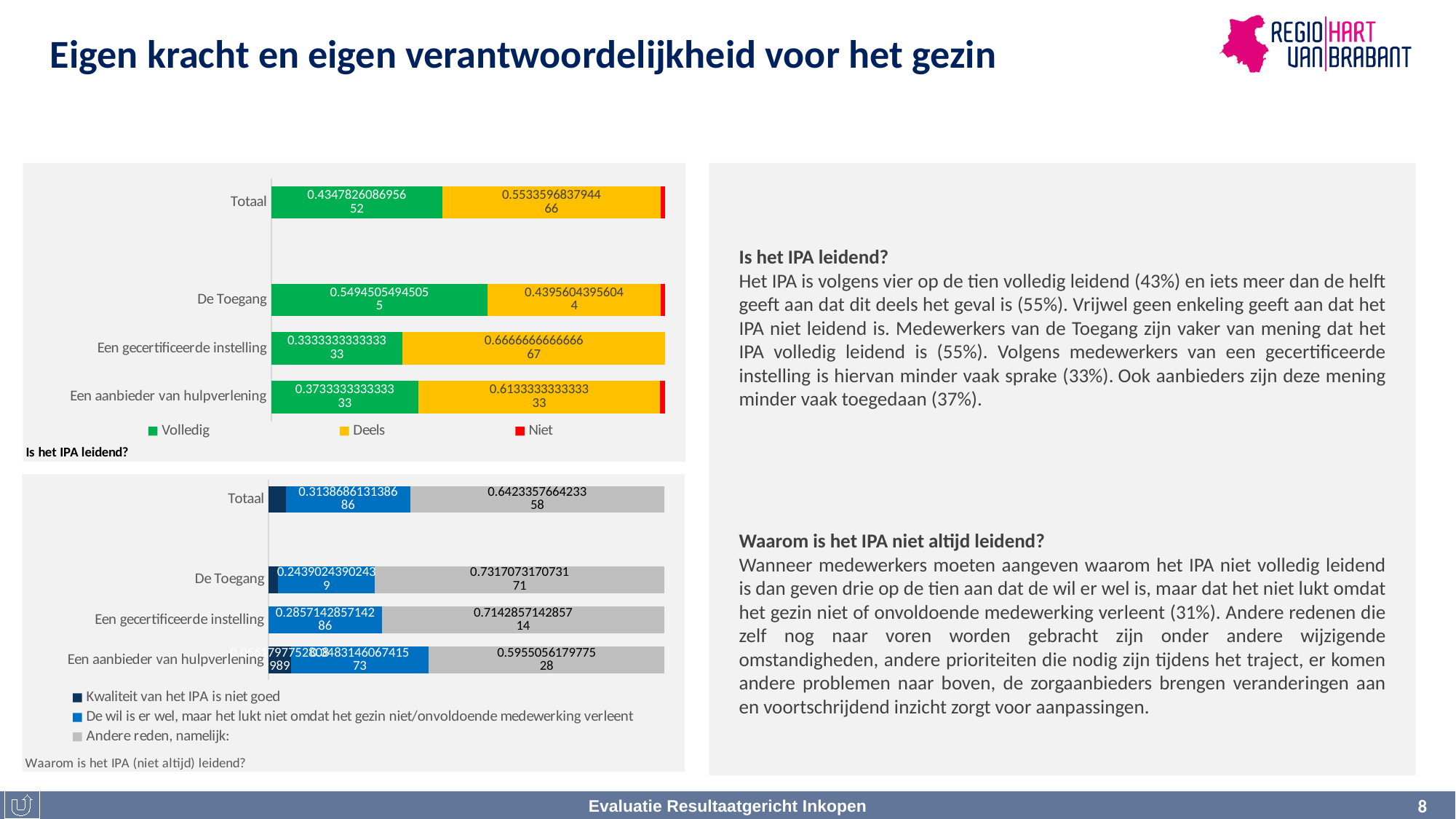
In the top chart 'Is het IPA leidend?', what is the Deels value for Een gecertificeerde instelling? 0.666666666666667 In the top chart 'Is het IPA leidend?', what is the Volledig value for Totaal? 0.434782608695652 In the top chart 'Is het IPA leidend?', which category has the lowest value for Volledig? Een gecertificeerde instelling In the bottom chart 'Waarom is het IPA (niet altijd) leidend?', what is the value of 'Andere reden, namelijk:' for De Toegang? 0.731707317073171 In the top chart 'Is het IPA leidend?', which category has the highest value for Volledig? De Toegang In the top chart 'Is het IPA leidend?', how many categories are shown on the vertical axis? 4 In the bottom chart 'Waarom is het IPA (niet altijd) leidend?', how many series does the legend list? 3 In the top chart 'Is het IPA leidend?', how many series does the legend list? 3 What kind of chart is the top chart titled 'Is het IPA leidend?'? Stacked bar chart In the top chart 'Is het IPA leidend?', is the Volledig value for De Toegang larger or smaller than the Deels value for De Toegang? Larger In the bottom chart 'Waarom is het IPA (niet altijd) leidend?', which category has the highest value for 'Andere reden, namelijk:'? De Toegang In the top chart 'Is het IPA leidend?', what colour represents the series 'Niet'? Red